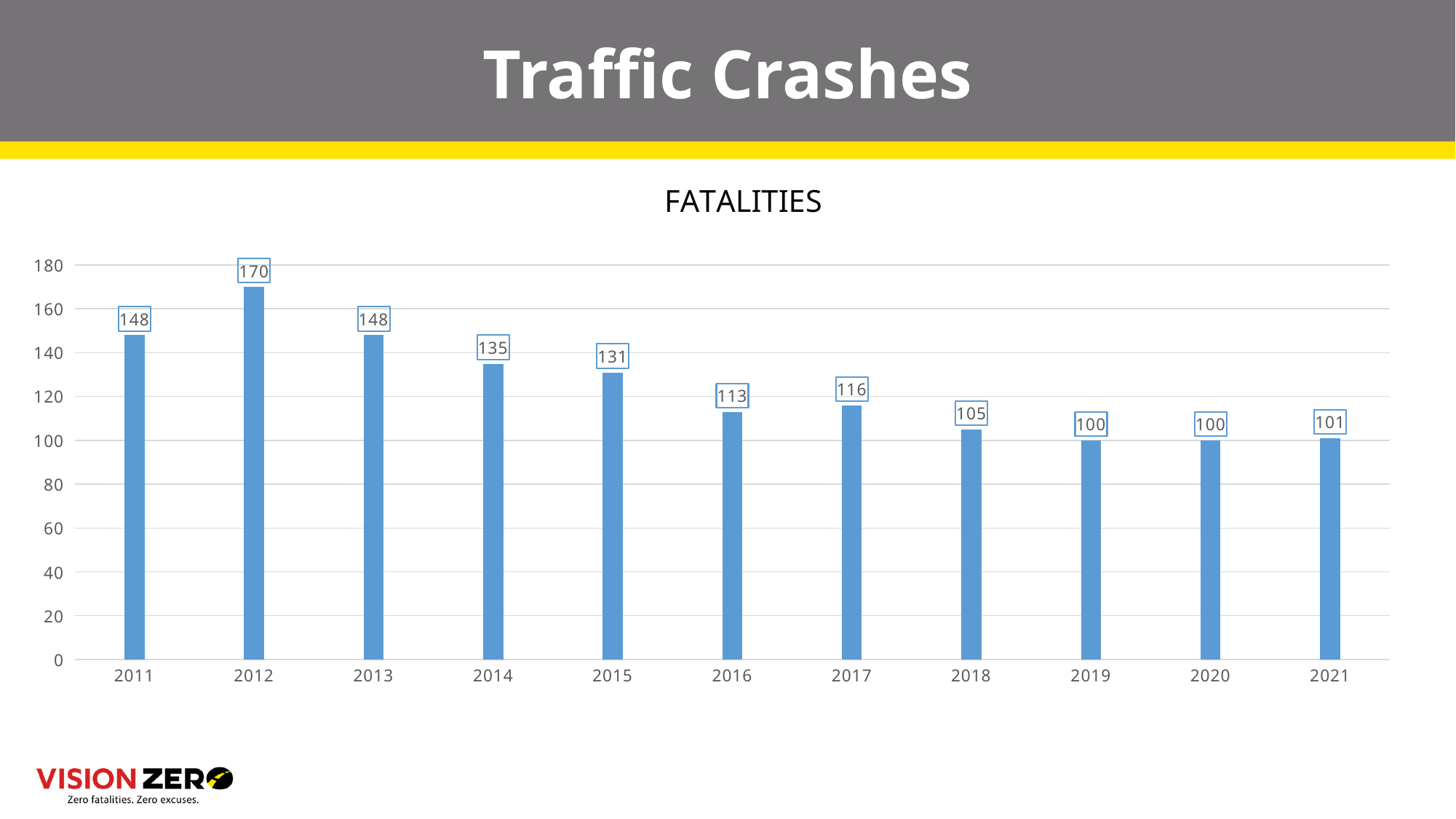
Which year has more fatalities, 2016 or 2017? 2017 What is the title of the chart? FATALITIES What is the number of fatalities in 2018? 105 What is the difference in fatalities between 2014 and 2015? 4 What kind of chart is shown on the slide? bar chart Do fatalities generally rise or fall from 2012 to 2021? fall Which year has the highest number of fatalities? 2012 What is the number of fatalities in 2012? 170 What is the number of fatalities in 2021? 101 How many years are shown on the x axis? 11 Is the value for 2014 greater or less than 120? greater What is the difference in fatalities between 2012 and 2013? 22